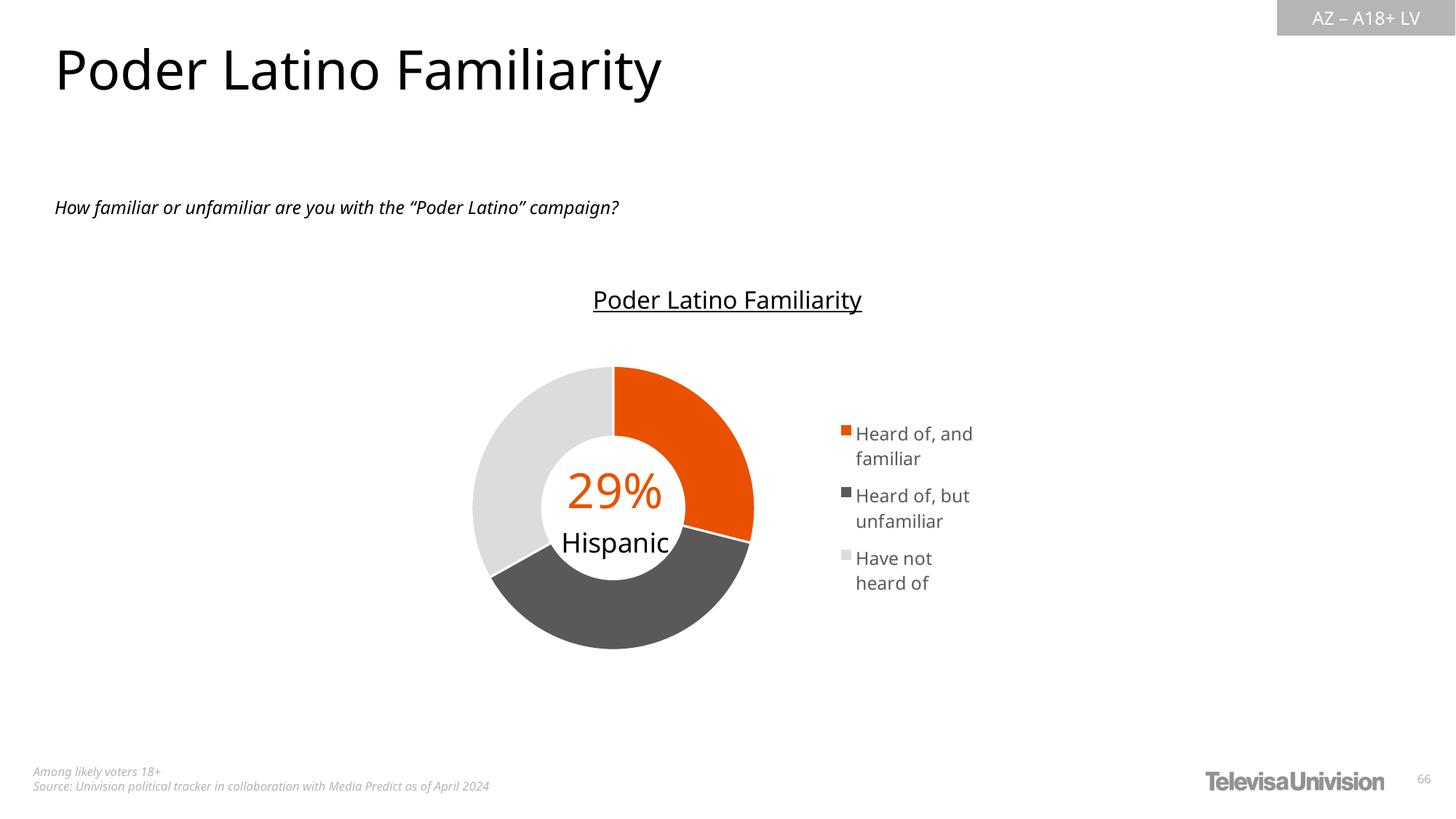
What kind of chart is shown on the slide? donut chart What percentage is shown for "Heard of, and familiar" in the Poder Latino Familiarity chart? 29% How many entries does the legend of the Poder Latino Familiarity chart list? 3 Which group label is printed in the center of the donut chart? Hispanic What is the title of the chart on the slide? Poder Latino Familiarity How many slices does the Poder Latino Familiarity chart have? 3 Which category has the smallest slice in the Poder Latino Familiarity chart? Heard of, and familiar Which slice is larger: "Heard of, and familiar" or "Heard of, but unfamiliar"? Heard of, but unfamiliar